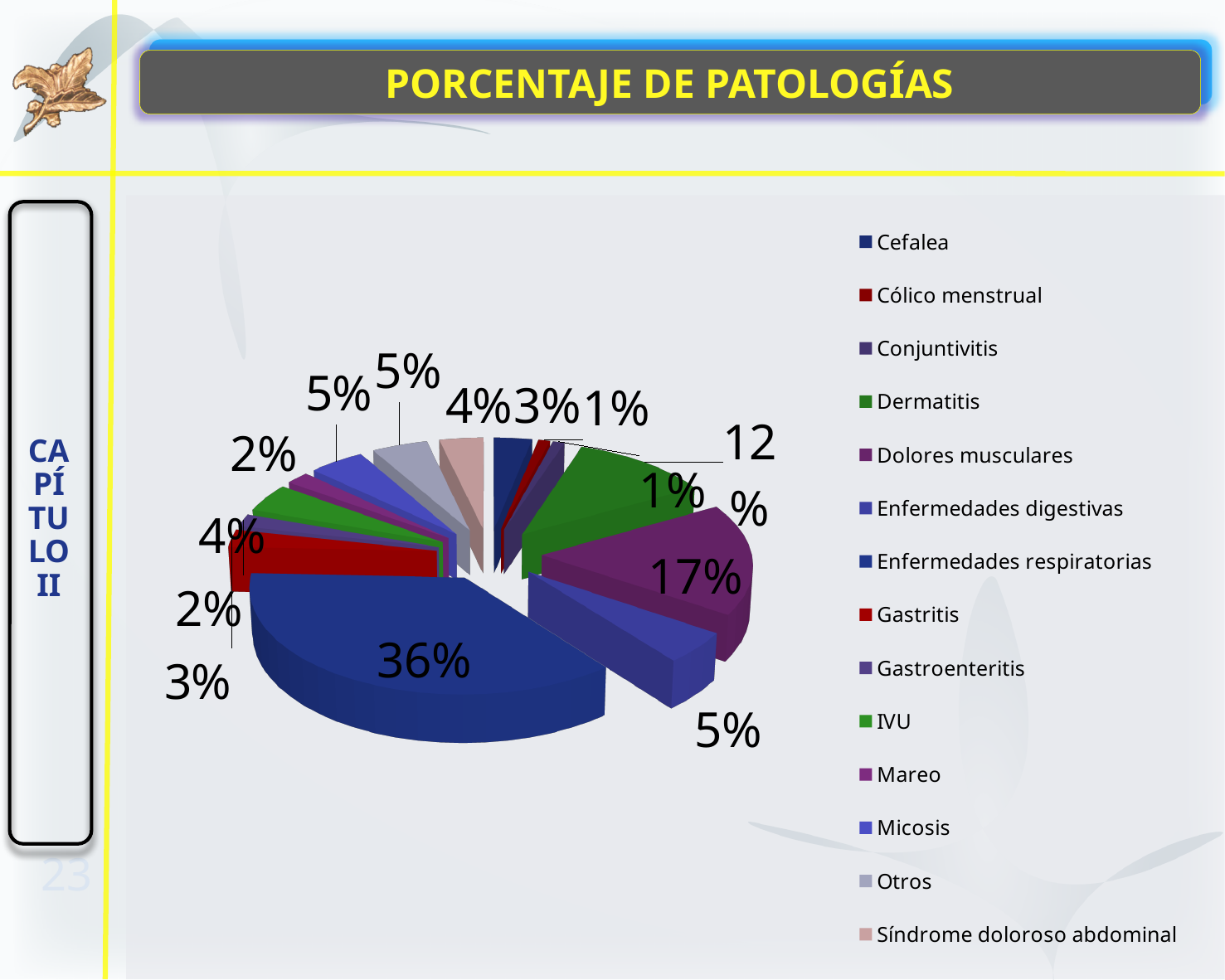
What is the title of the chart? PORCENTAJE DE PATOLOGÍAS What percentage is shown for Enfermedades respiratorias? 36% What percentage is shown for Dermatitis? 12% Which legend entry is listed last in the pie chart's legend? Síndrome doloroso abdominal What type of chart is shown on the slide? pie chart Which is larger, the slice for Dolores musculares or the slice for Dermatitis? Dolores musculares What percentage is shown for Enfermedades digestivas? 5% What is the smallest percentage value labelled on the pie chart? 1% Which category has the largest slice of the pie chart? Enfermedades respiratorias What is the difference in percentage points between Enfermedades respiratorias and Dolores musculares? 19 How many categories does the legend of the pie chart list? 14 What percentage is shown for Dolores musculares? 17%